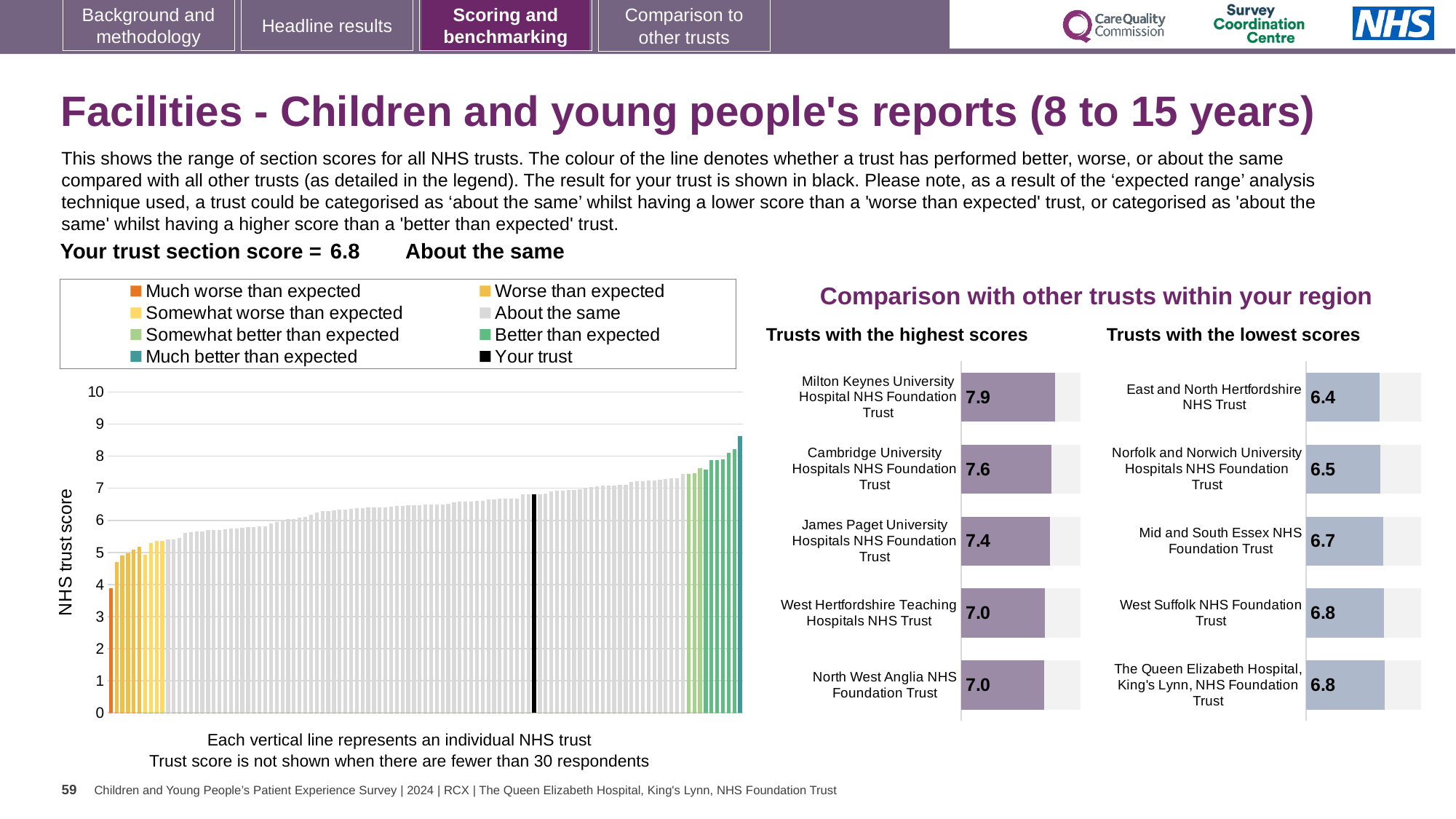
In the 'Trusts with the highest scores' chart, which trust has the lowest score shown? West Hertfordshire Teaching Hospitals NHS Trust and North West Anglia NHS Foundation Trust (both 7.0) How many entries does the legend of the large chart on the left list? 8 In the large chart on the left, is the value of the tallest bar greater or less than 8? greater In the large chart on the left, do the trust scores rise or fall from left to right? Rise In the 'Trusts with the highest scores' chart, what is the difference between the scores of Milton Keynes University Hospital NHS Foundation Trust and James Paget University Hospitals NHS Foundation Trust? 0.5 In the 'Trusts with the lowest scores' chart, which has the higher score: Norfolk and Norwich University Hospitals NHS Foundation Trust or Mid and South Essex NHS Foundation Trust? Mid and South Essex NHS Foundation Trust In the 'Trusts with the highest scores' chart, what is the score for Milton Keynes University Hospital NHS Foundation Trust? 7.9 What kind of chart is the large chart on the left showing NHS trust scores? Bar chart In the 'Trusts with the lowest scores' chart, what is the score for East and North Hertfordshire NHS Trust? 6.4 In the 'Trusts with the lowest scores' chart, what is the score for The Queen Elizabeth Hospital, King's Lynn, NHS Foundation Trust? 6.8 How many trusts are listed in the 'Trusts with the highest scores' chart? 5 In the 'Trusts with the lowest scores' chart, which trust has the lowest score? East and North Hertfordshire NHS Trust